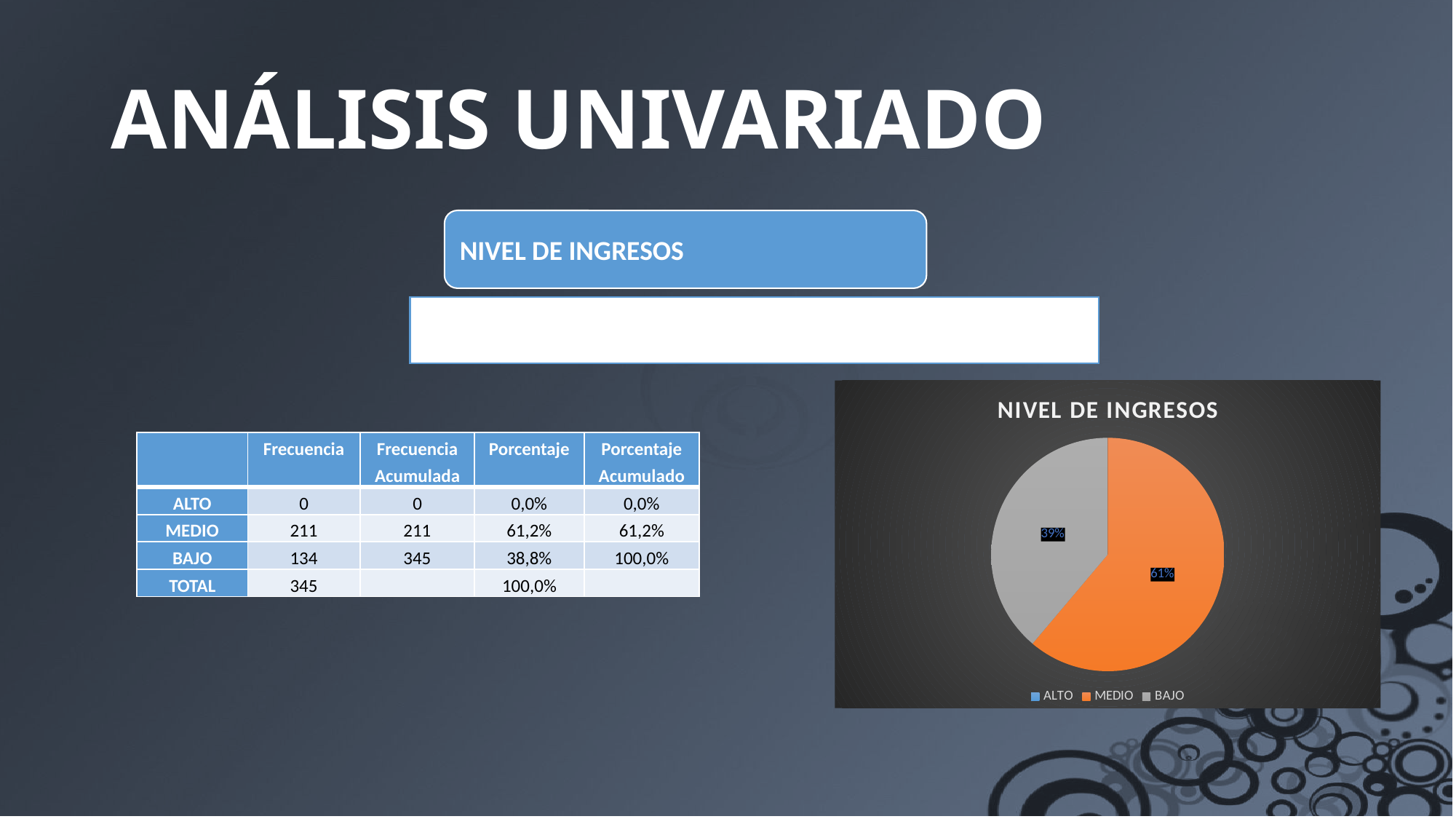
What share of the pie does the BAJO slice represent? 39% What is the title of the chart? NIVEL DE INGRESOS Which category has the largest slice in the pie chart? MEDIO What share of the pie does the MEDIO slice represent? 61% Is the share for MEDIO greater or less than 50%? greater Is the share for BAJO greater or less than 50%? less How many slices are visibly drawn in the pie chart? 2 How many entries does the chart's legend list? 3 What type of chart is shown on the slide? pie chart What is the difference in percentage points between the MEDIO and BAJO slices? 22 Which of the two visible slices is larger, MEDIO or BAJO? MEDIO Which colour represents the MEDIO category in the pie chart? orange